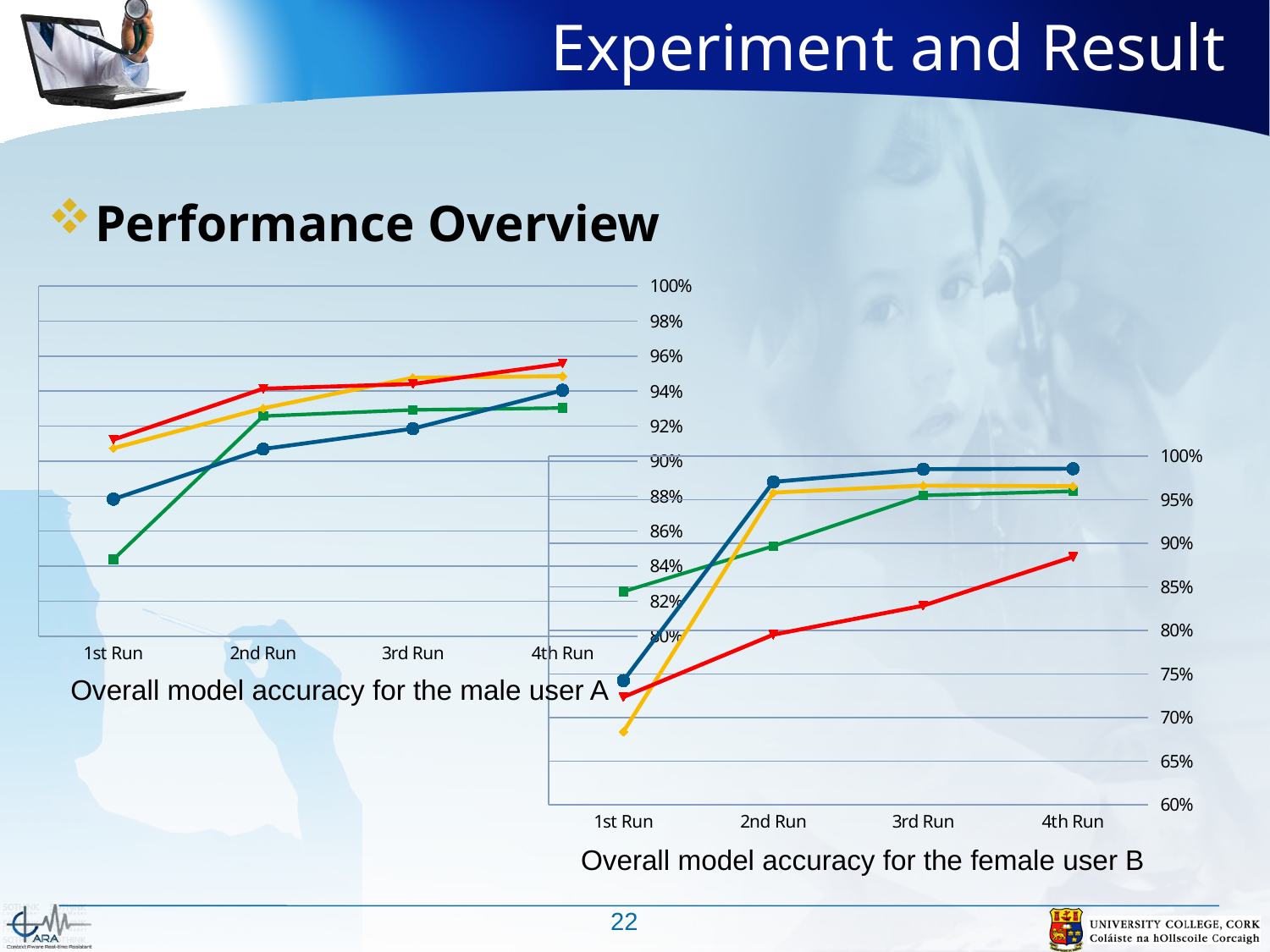
In the 'Overall model accuracy for the female user B' chart, which coloured line is lowest at 4th Run? red How many runs are shown on the x axis of the 'Overall model accuracy for the male user A' chart? 4 What kind of chart is 'Overall model accuracy for the male user A'? line chart In the 'Overall model accuracy for the male user A' chart, is the green line's value at 1st Run greater or less than 86%? less In the 'Overall model accuracy for the female user B' chart, does the red line rise or fall from 1st Run to 4th Run? rise In the 'Overall model accuracy for the female user B' chart, is the yellow line's value at 1st Run greater or less than 70%? less In the 'Overall model accuracy for the female user B' chart, which coloured line is lowest at 1st Run? yellow In the 'Overall model accuracy for the male user A' chart, which coloured line is lowest at 1st Run? green How many lines are plotted in the 'Overall model accuracy for the female user B' chart? 4 In the 'Overall model accuracy for the female user B' chart, is the red line's value at 4th Run greater or less than 85%? greater In the 'Overall model accuracy for the male user A' chart, do the lines generally rise or fall from 1st Run to 4th Run? rise What kind of chart is 'Overall model accuracy for the female user B'? line chart